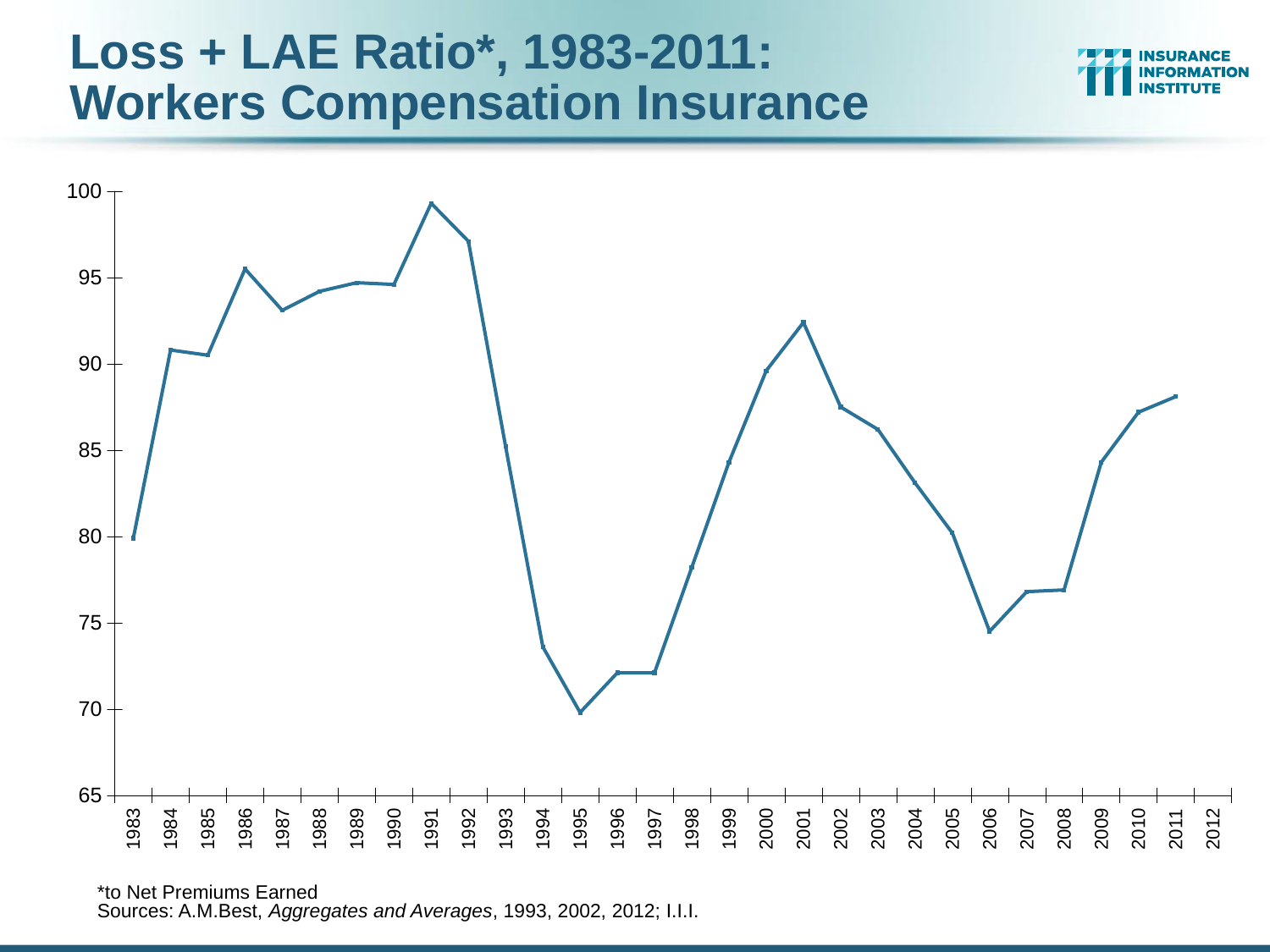
Is the value for 2001 greater or less than 90? greater What kind of chart is shown on the slide? line chart Which year has the larger Loss + LAE ratio, 1983 or 1984? 1984 Which year has the lowest Loss + LAE ratio? 1995 Which year has the larger Loss + LAE ratio, 2001 or 2006? 2001 Does the Loss + LAE ratio rise or fall from 2006 to 2011? rise Is the value for 2006 greater or less than 75? less Is the value for 2011 greater or less than 90? less Does the Loss + LAE ratio rise or fall from 1991 to 1995? fall Which year has the highest Loss + LAE ratio? 1991